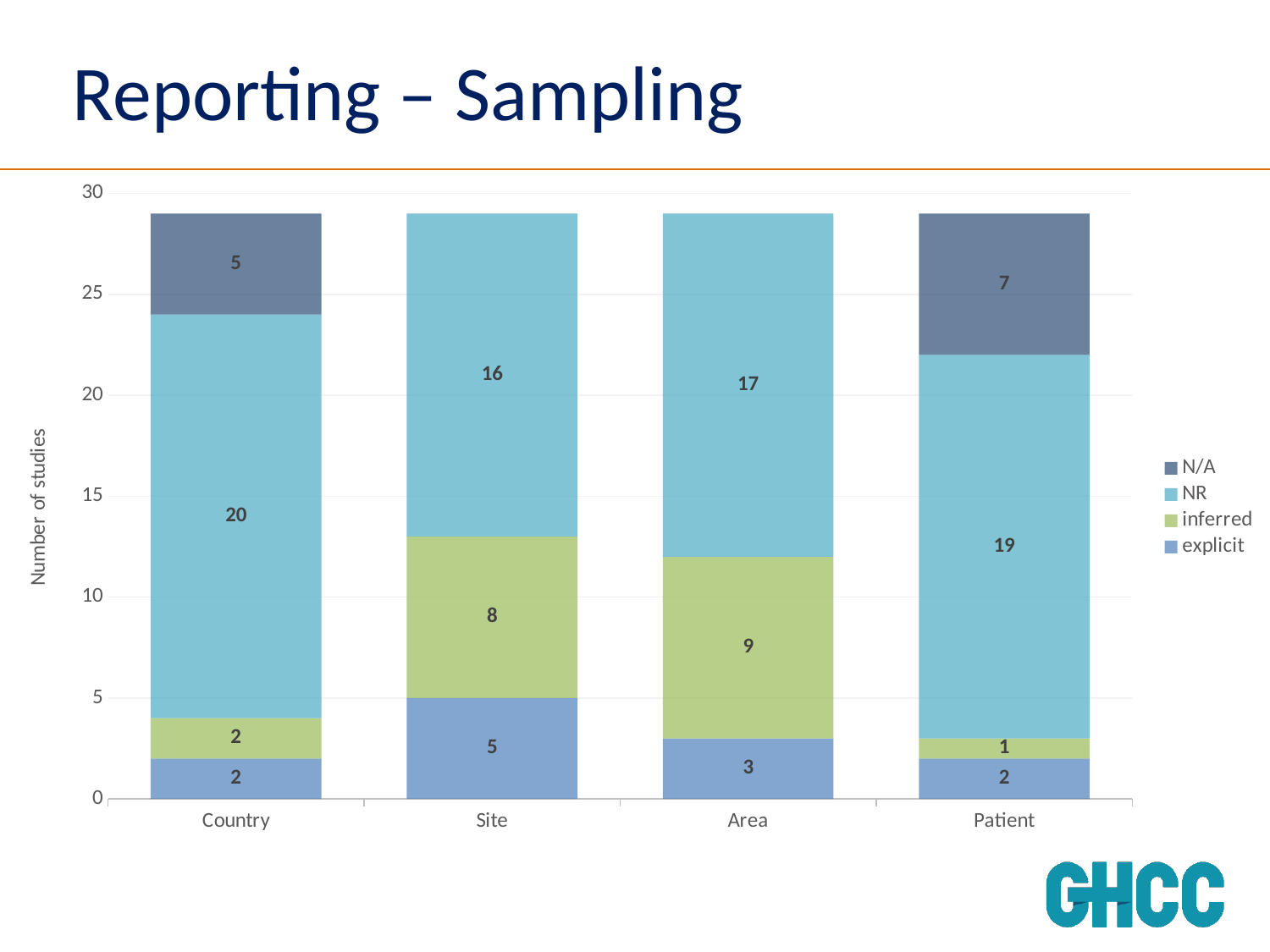
What is the inferred value for Area? 9 What kind of chart is shown on the slide? Stacked bar chart How many categories are shown on the x axis? 4 What is the NR value for Country? 20 What is the total of the stacked bar for Country? 29 What is the N/A value for Patient? 7 Which category has the lowest inferred value? Patient What is the explicit value for Site? 5 What is the difference between the NR value for Patient and the NR value for Site? 3 How many series does the legend list? 4 Which has the larger inferred value, Site or Area? Area Which category has the highest NR value? Country